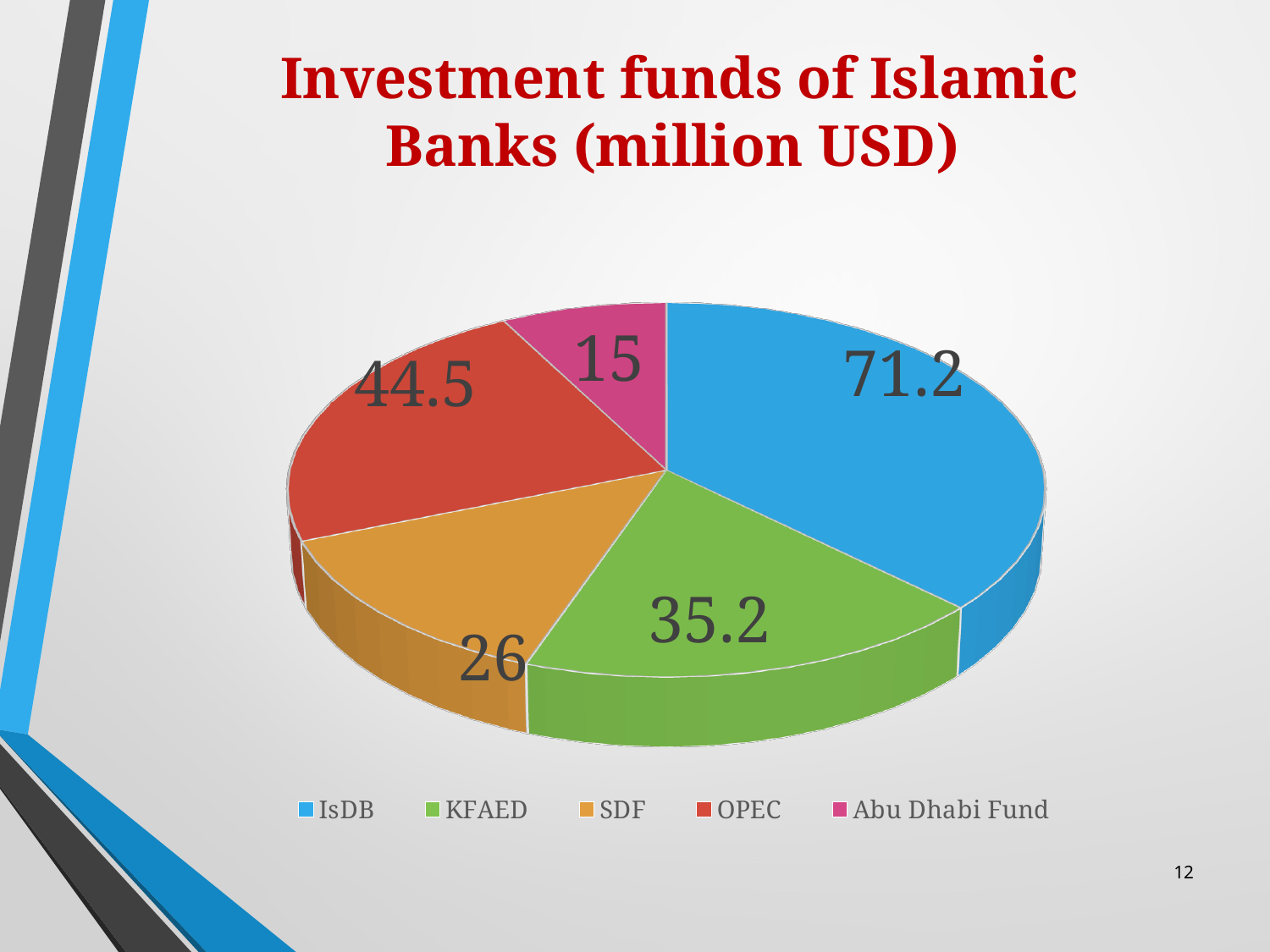
What is the value for IsDB? 71.2 What is the value for SDF? 26 Which fund has the largest slice? IsDB What is the difference between the values for KFAED and SDF? 9.2 What is the value for Abu Dhabi Fund? 15 What is the value for OPEC? 44.5 Which fund has the smallest slice? Abu Dhabi Fund Which is larger, the value for OPEC or the value for KFAED? OPEC How many slices does the pie chart have? 5 What kind of chart is shown on the slide? Pie chart What colour is the slice for KFAED? Green What is the difference between the values for IsDB and OPEC? 26.7